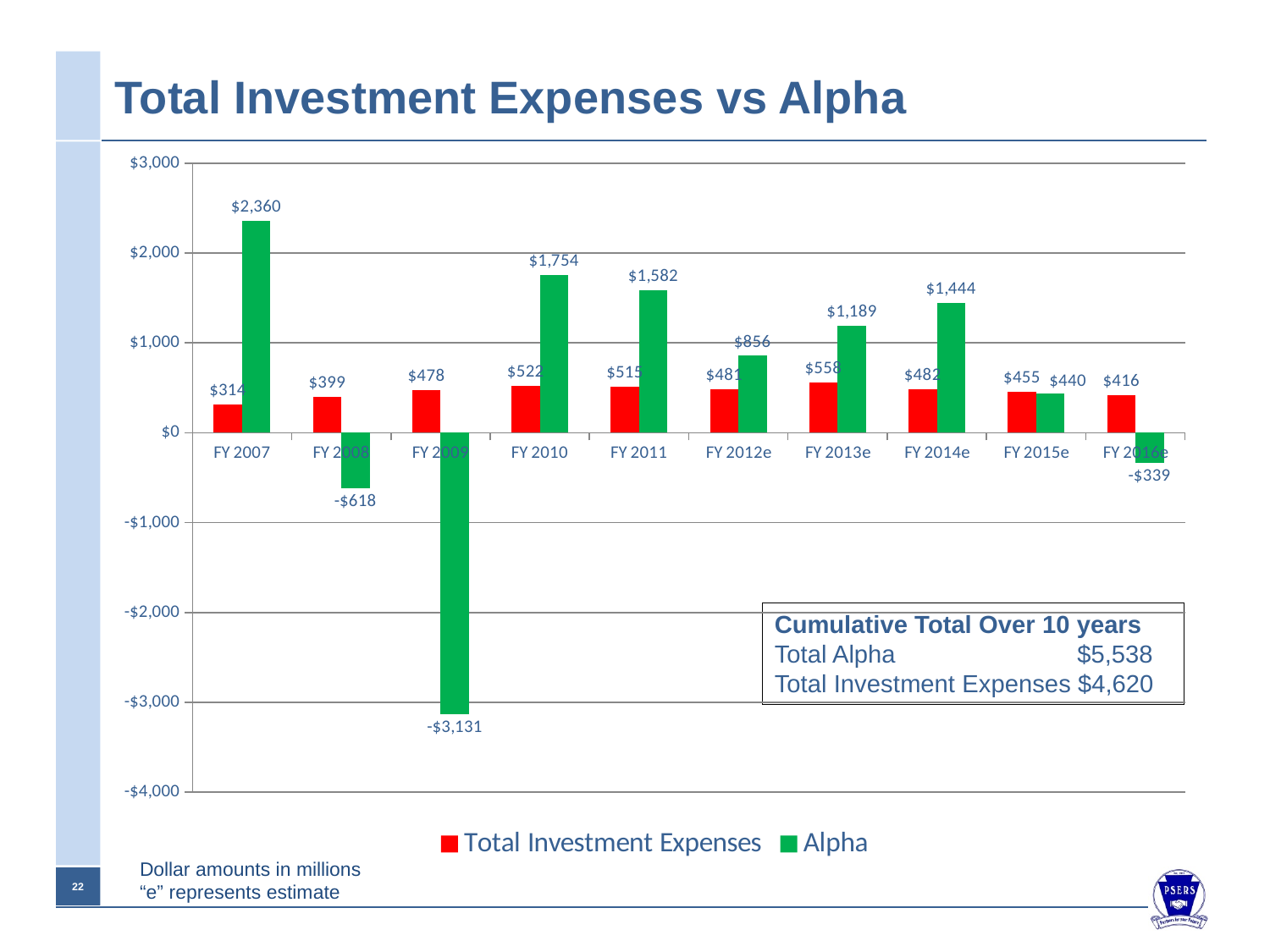
What is the Alpha value for FY 2009? -$3,131 How many fiscal years are shown on the x axis? 10 What kind of chart is shown on the slide? Bar chart Is the Alpha value for FY 2014e greater or less than $1,000? greater What is the Alpha value for FY 2007? $2,360 What is the Total Investment Expenses value for FY 2013e? $558 What is the cumulative Total Alpha over 10 years shown in the box on the chart? $5,538 What is the difference between Alpha and Total Investment Expenses in FY 2010? $1,232 How many series does the legend list? 2 Which fiscal year has the highest Alpha value? FY 2007 Which is larger in FY 2015e, Total Investment Expenses or Alpha? Total Investment Expenses Which fiscal year has the lowest Alpha value? FY 2009